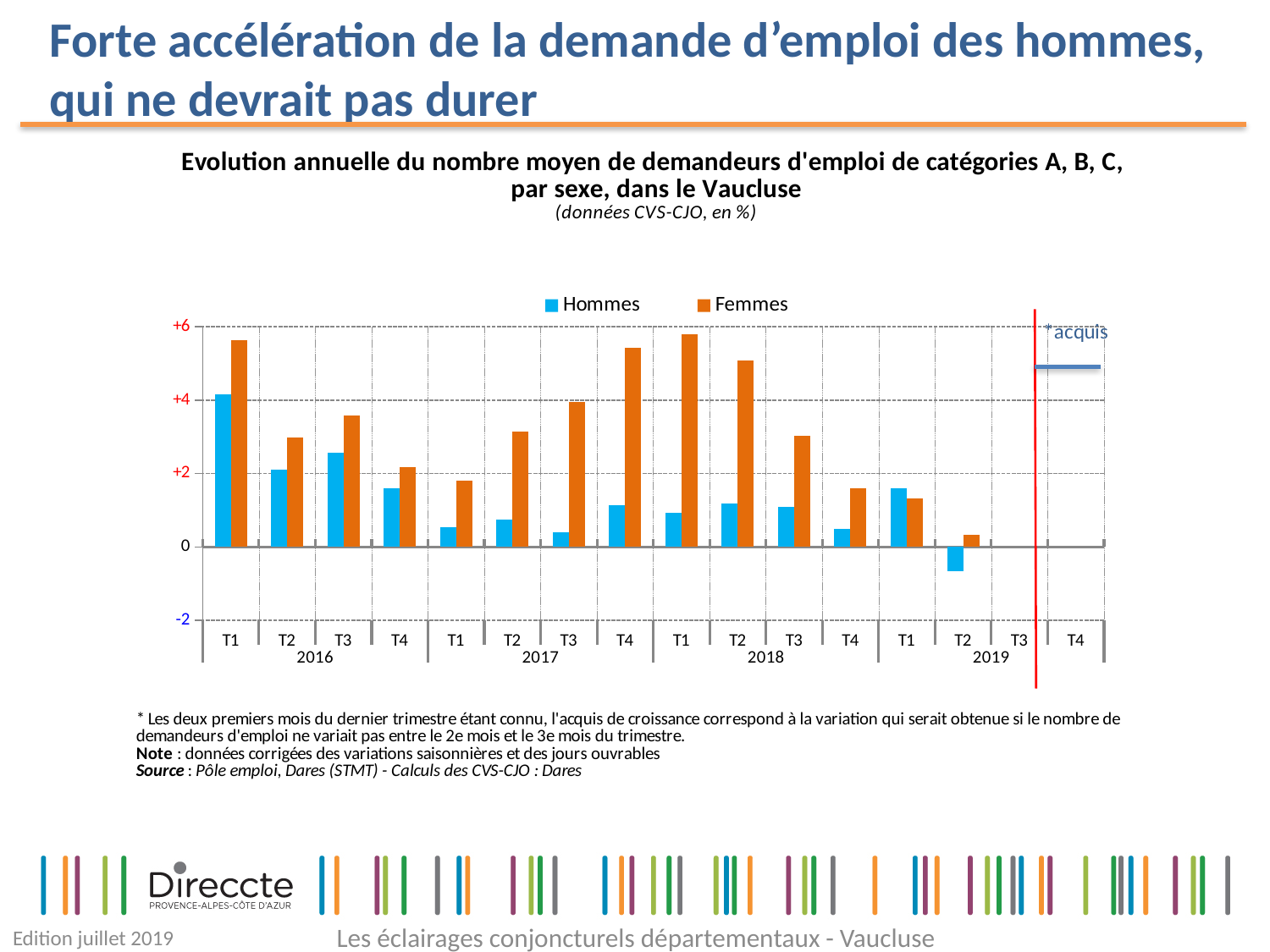
What are the two series named in the legend? Hommes and Femmes How many series does the legend list? 2 In which quarter is the Femmes value lowest? T2 2019 Is the Hommes value for T3 2017 greater or less than +2? less In which quarter is the Hommes value highest? T1 2016 In which quarter is the Hommes value lowest? T2 2019 What kind of chart is shown on the slide? bar chart Is the Femmes value for T1 2016 greater or less than +4? greater In T1 2018, which series has the larger value, Hommes or Femmes? Femmes Which colour represents the Femmes series? orange Is the Hommes value for T2 2019 greater or less than 0? less How many quarters have bars plotted in the chart? 14